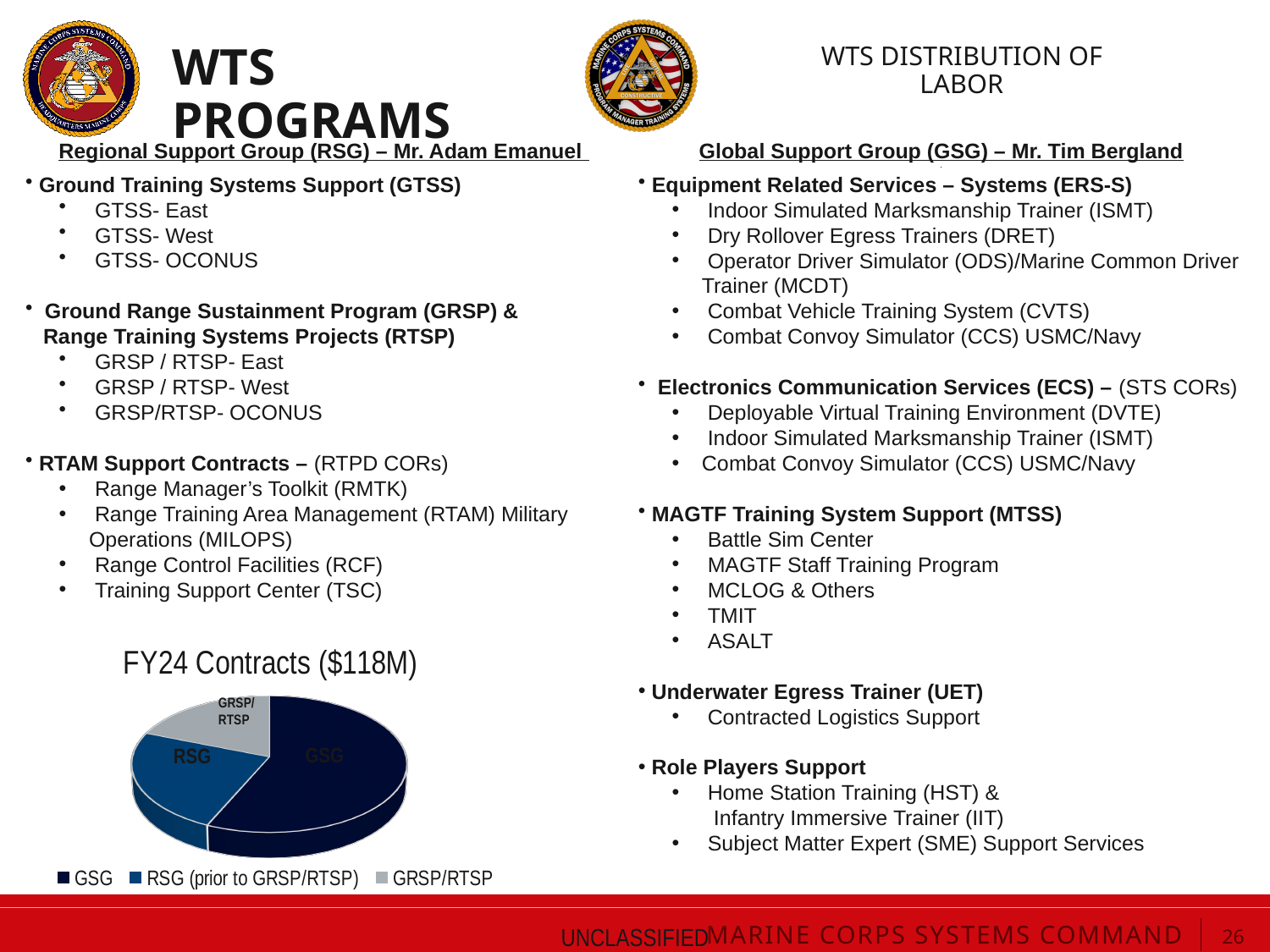
What kind of chart is shown on the slide? pie chart How many entries does the pie chart's legend list? 3 What total dollar amount is given in the pie chart's title? $118M What is the title of the pie chart? FY24 Contracts ($118M) Which slice of the pie chart is the smallest? GRSP/RTSP In the pie chart, which is larger: the RSG slice or the GRSP/RTSP slice? RSG Which slice of the pie chart is the largest? GSG How many slices does the pie chart have? 3 In the pie chart, which is larger: the GSG slice or the RSG slice? GSG